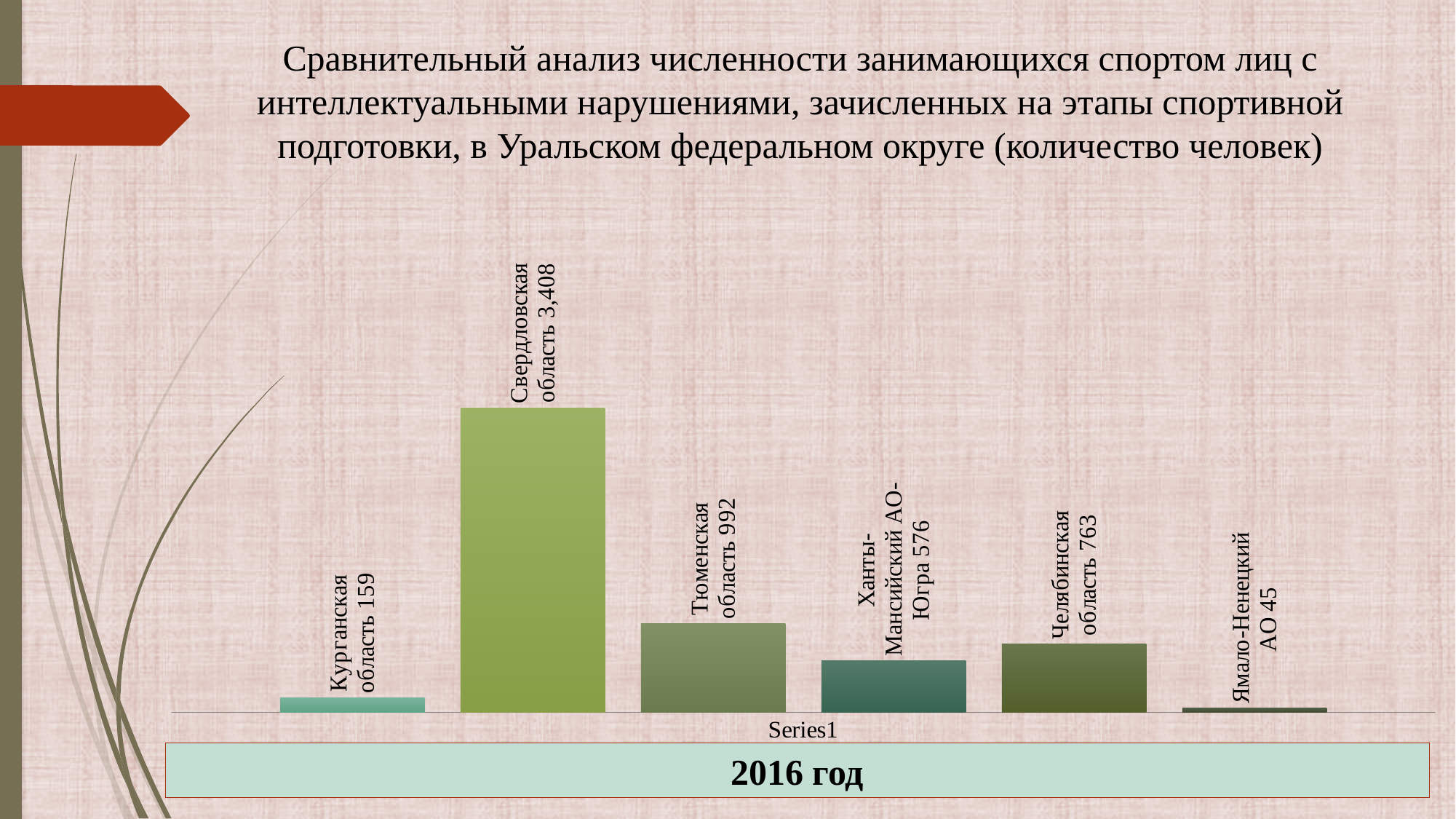
What is the value for Свердловская область? 3,408 What is the difference between the values for Курганская область and Ямало-Ненецкий АО? 114 Which region has the lowest value? Ямало-Ненецкий АО What is the value for Ямало-Ненецкий АО? 45 Which is larger, the value for Челябинская область or the value for Ханты-Мансийский АО-Югра? Челябинская область Which region has the highest value? Свердловская область What year is indicated below the chart? 2016 год What kind of chart is shown on the slide? Bar chart How many bars are shown in the chart? 6 What is the value for Тюменская область? 992 What is the difference between the values for Тюменская область and Челябинская область? 229 What is the value for Ханты-Мансийский АО-Югра? 576